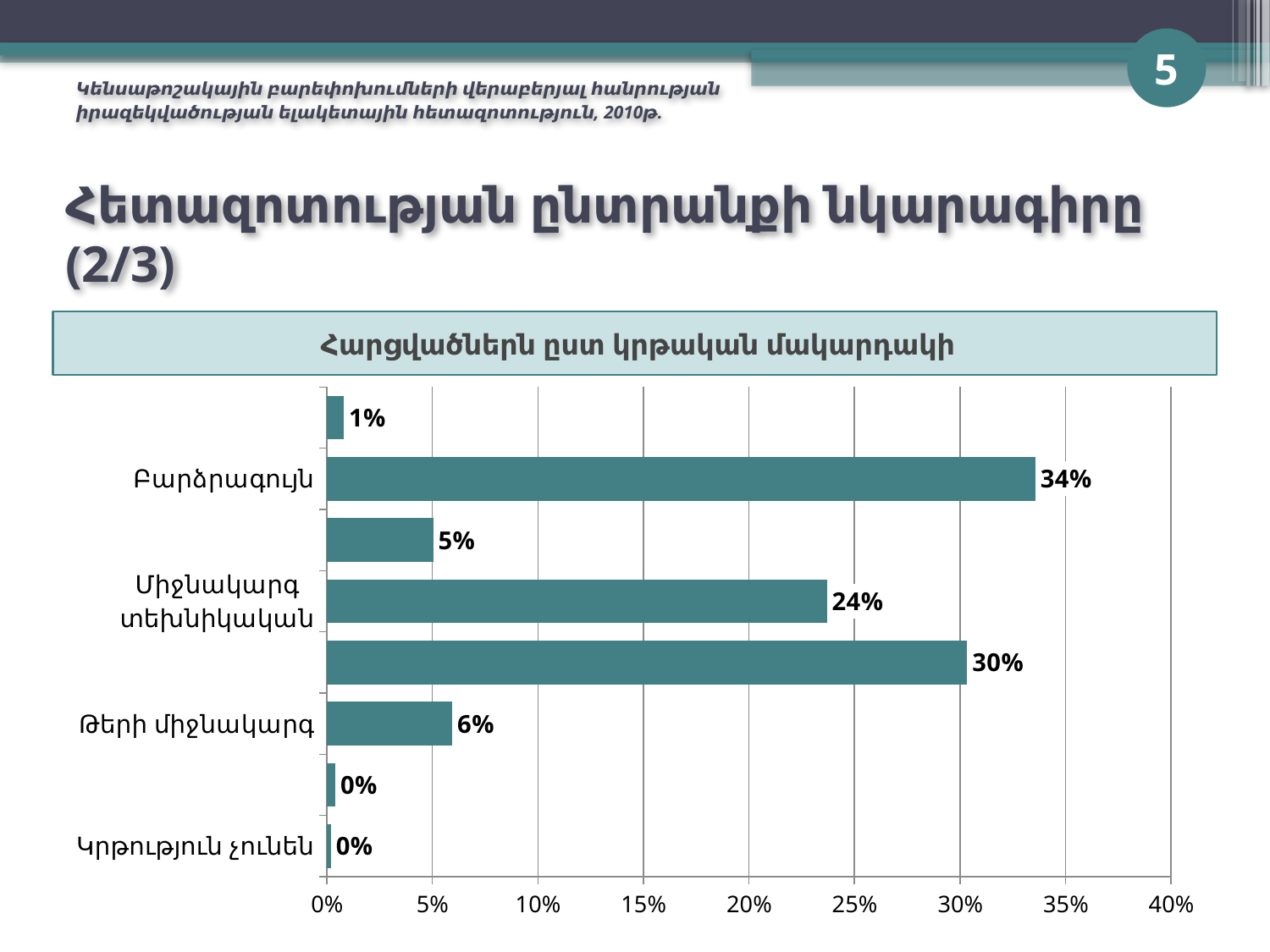
What is the value for Կրթություն չունեն? 0% What is the title of the chart? Հարցվածներն ըստ կրթական մակարդակի What is the difference between the values for Բարձրագույն and Միջնակարգ տեխնիկական? 10% Which is larger, the value for Բարձրագույն or the value for Միջնակարգ տեխնիկական? Բարձրագույն What is the value for Միջնակարգ տեխնիկական? 24% Is the value for Բարձրագույն greater or less than 30%? greater How many bars are plotted in the chart? 8 What is the highest value shown by any bar in the chart? 34% What is the difference between the values for Միջնակարգ տեխնիկական and Թերի միջնակարգ? 18% What is the value for Բարձրագույն? 34% What is the value for Թերի միջնակարգ? 6% What type of chart is shown on the slide? bar chart